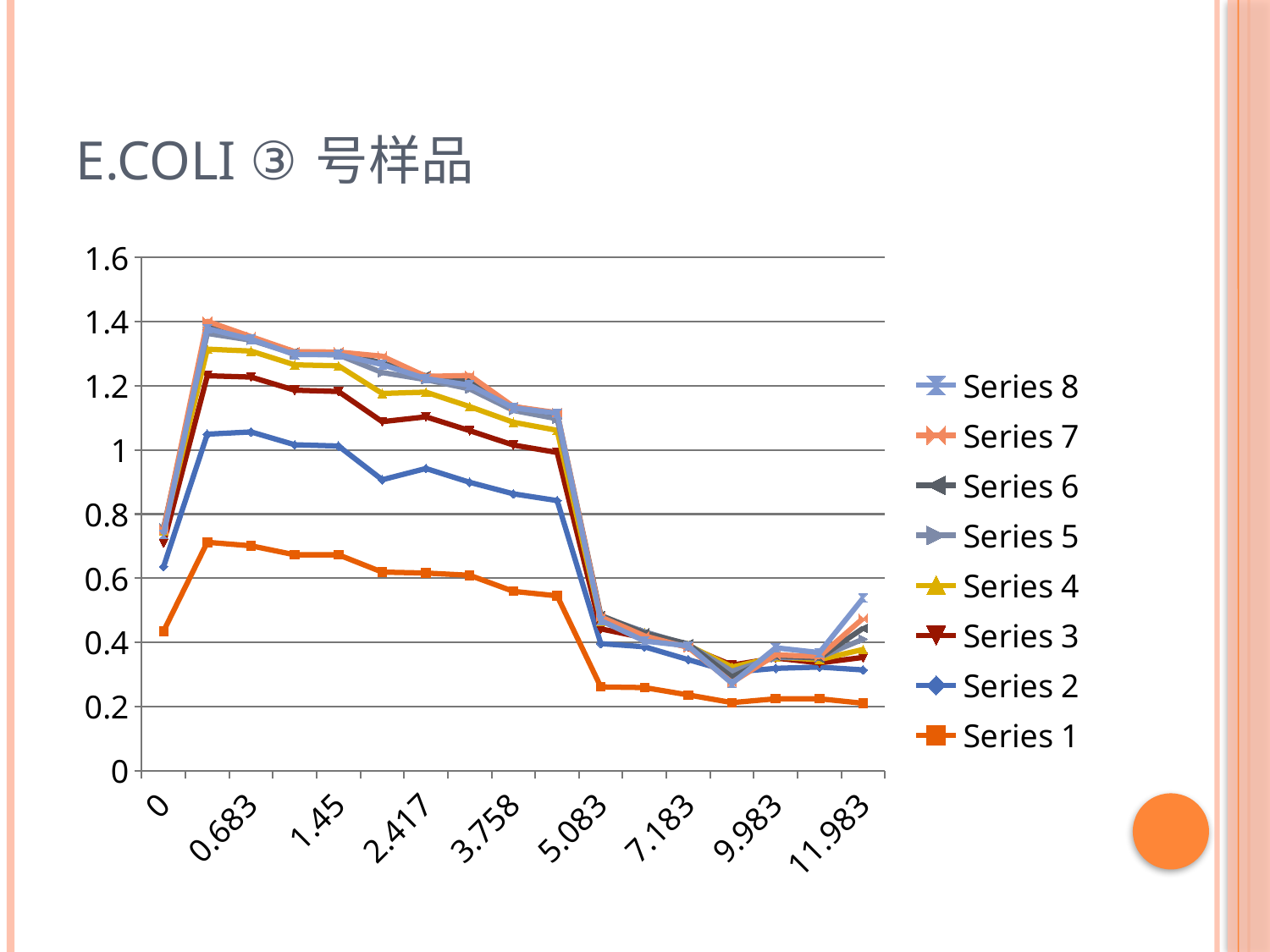
What is the title of the slide containing the chart? E.COLI ③ 号样品 Which series is drawn in orange with square markers? Series 1 Overall, do the values for Series 1 rise or fall from x = 0.683 to x = 11.983? fall Is the value for Series 1 at x = 0 greater or less than 0.6? less Is the value for Series 3 at x = 0 greater or less than 0.8? less What kind of chart is shown on the slide? line chart How many series does the legend list? 8 Is the value for Series 1 at x = 11.983 greater or less than 0.4? less